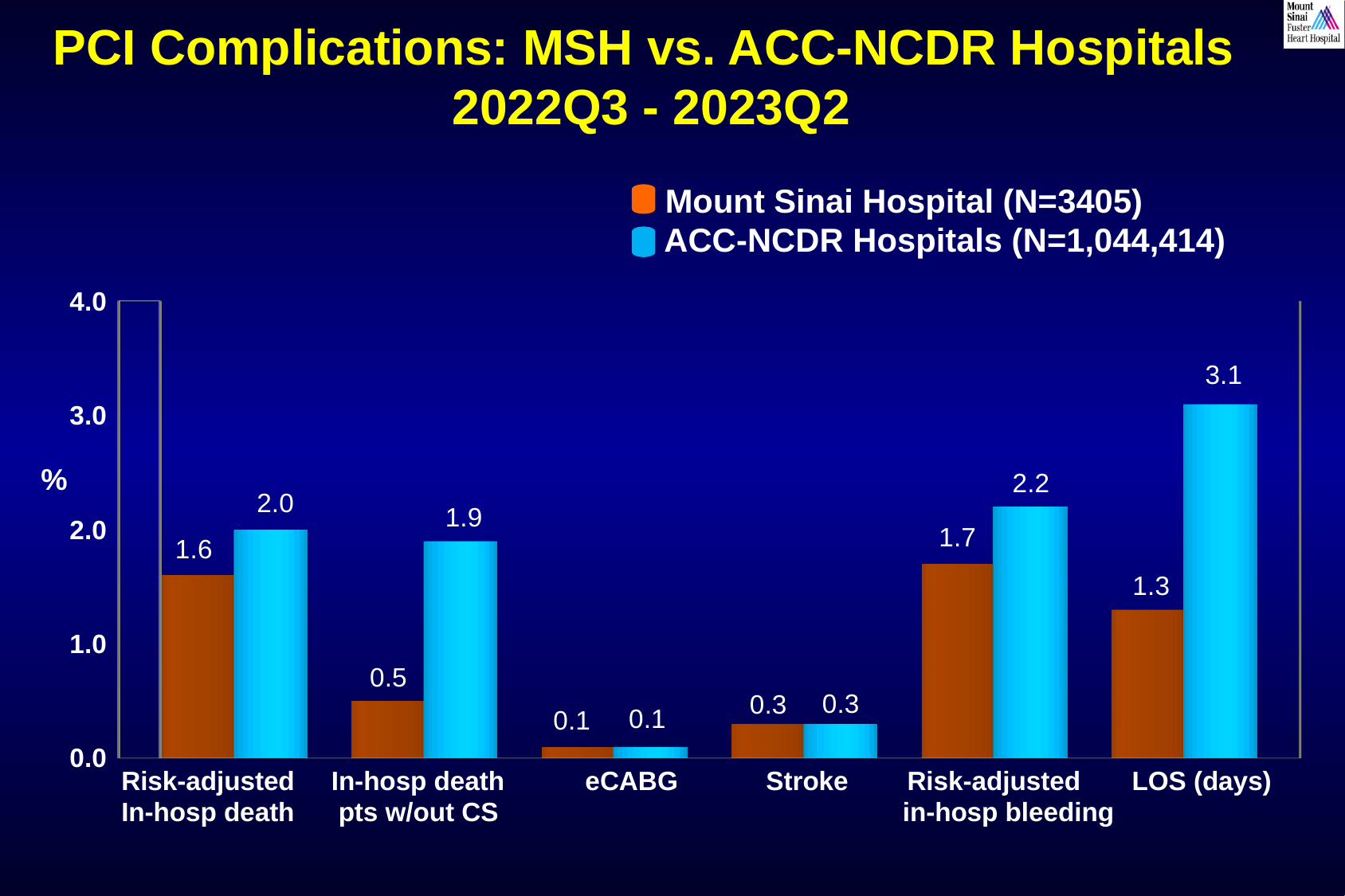
Which colour represents Mount Sinai Hospital in the chart? Orange Which category has the highest ACC-NCDR Hospitals value? LOS (days) What kind of chart is shown on the slide? Bar chart What is the Mount Sinai Hospital value for Risk-adjusted In-hosp death? 1.6 For Risk-adjusted in-hosp bleeding, which is larger: Mount Sinai Hospital or ACC-NCDR Hospitals? ACC-NCDR Hospitals How many series does the legend list? 2 What is the difference between the ACC-NCDR Hospitals and Mount Sinai Hospital values for LOS (days)? 1.8 What is the difference between the ACC-NCDR Hospitals and Mount Sinai Hospital values for In-hosp death pts w/out CS? 1.4 What is the ACC-NCDR Hospitals value for In-hosp death pts w/out CS? 1.9 How many categories are shown on the x axis? 6 Which category has the lowest Mount Sinai Hospital value? eCABG What is the ACC-NCDR Hospitals value for LOS (days)? 3.1